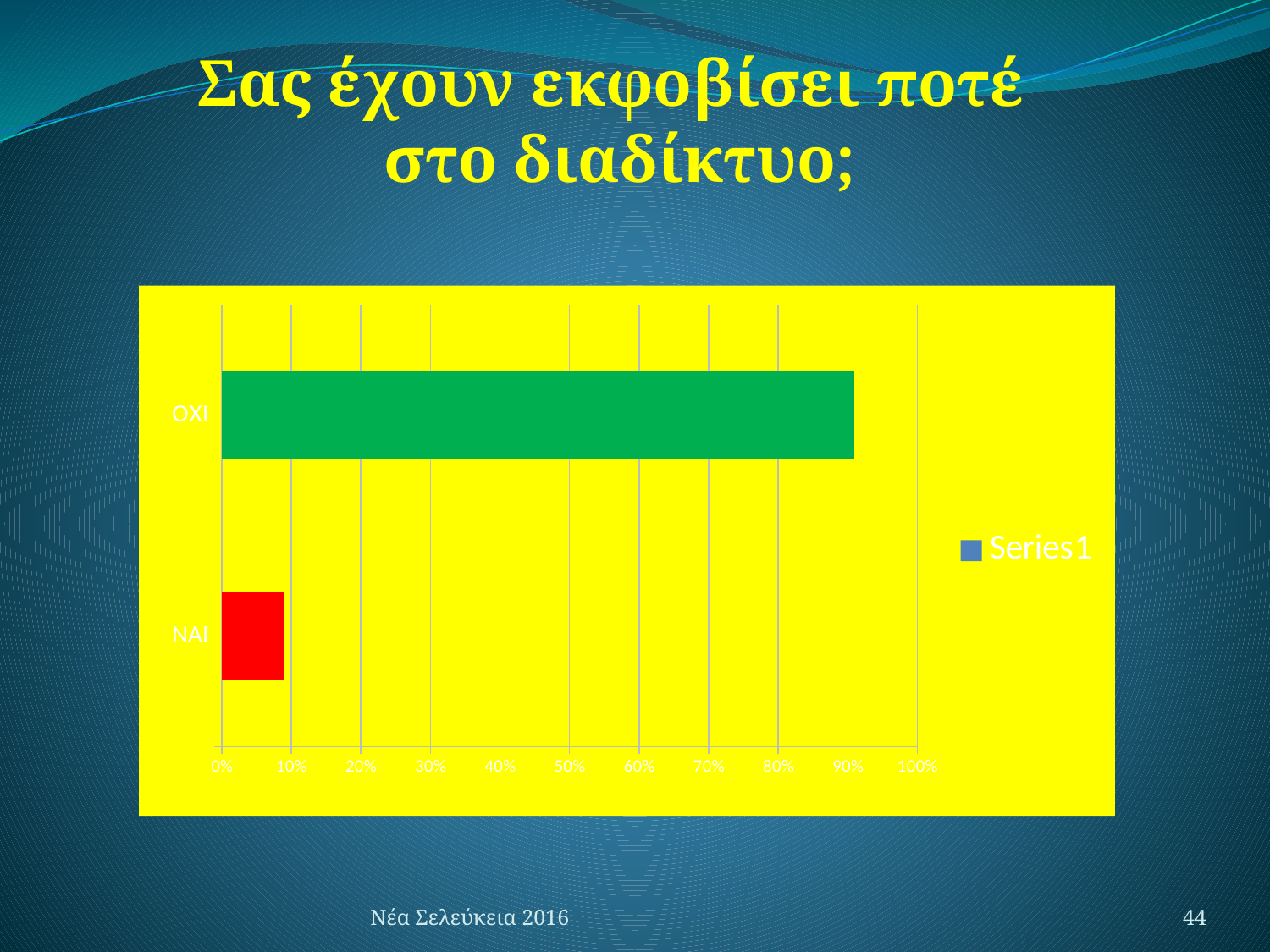
What is the name of the series shown in the legend? Series1 Is the value for ΟΧΙ greater or less than 80%? greater How many categories are plotted in the chart? 2 Which category has the lowest value? ΝΑΙ Is the value for ΟΧΙ greater or less than 50%? greater Which category has the highest value? ΟΧΙ Which is larger, the value for ΟΧΙ or the value for ΝΑΙ? ΟΧΙ What kind of chart is shown on the slide? bar chart What is the title of the slide containing the chart? Σας έχουν εκφοβίσει ποτέ στο διαδίκτυο; Is the value for ΝΑΙ greater or less than 20%? less How many series does the legend list? 1